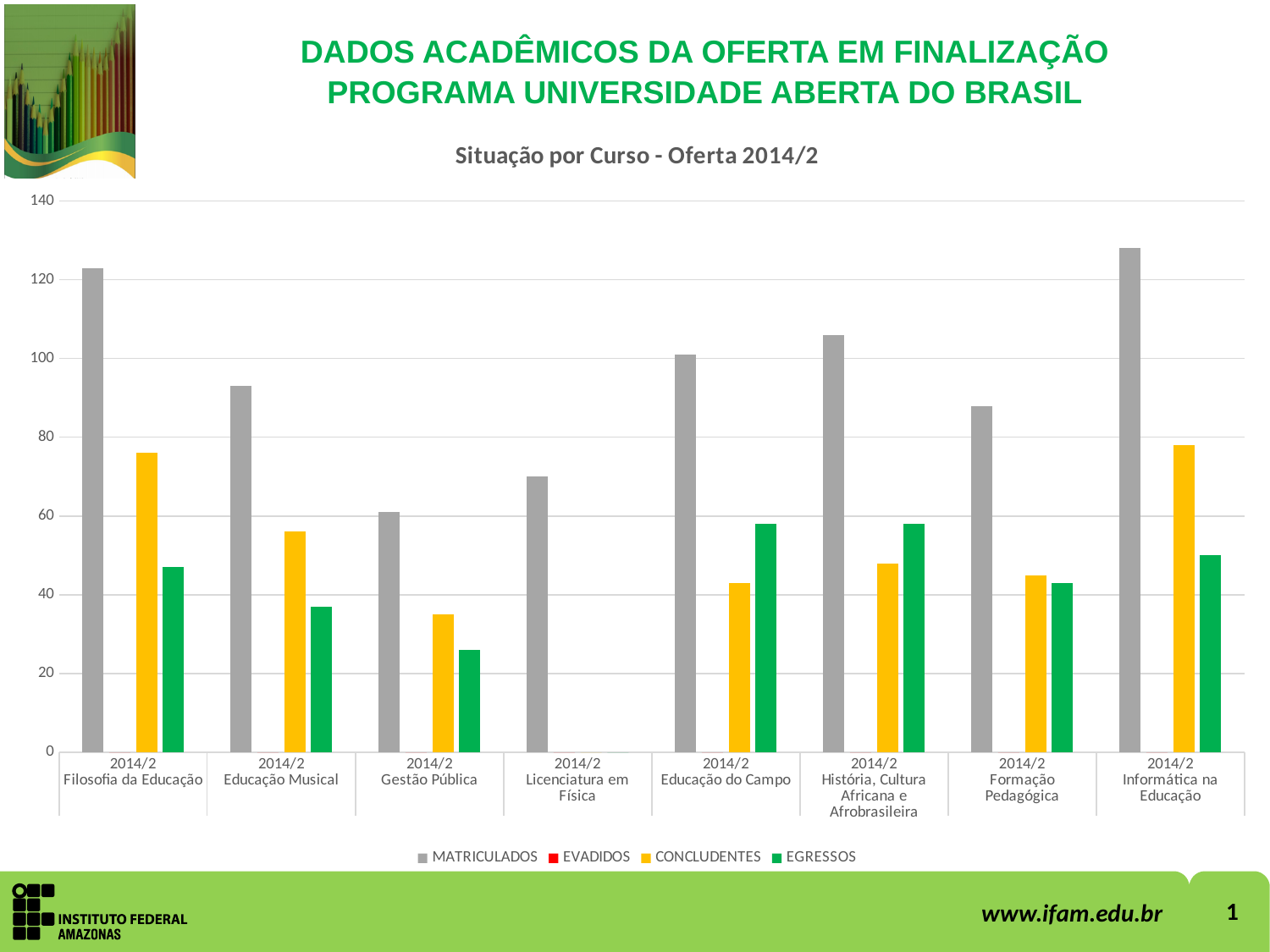
How many series does the legend list? 4 Is the MATRICULADOS value for Licenciatura em Física greater or less than 60? greater Which course has the lowest MATRICULADOS value? Gestão Pública For Filosofia da Educação, which is larger: CONCLUDENTES or EGRESSOS? CONCLUDENTES Is the MATRICULADOS value for Informática na Educação greater or less than 120? greater Is the MATRICULADOS value for Educação Musical greater or less than 100? less What kind of chart is shown on the slide? bar chart What is the title of the chart? Situação por Curso - Oferta 2014/2 Which course has the highest MATRICULADOS value? Informática na Educação For Educação do Campo, which is larger: CONCLUDENTES or EGRESSOS? EGRESSOS How many courses (categories) are shown on the x axis? 8